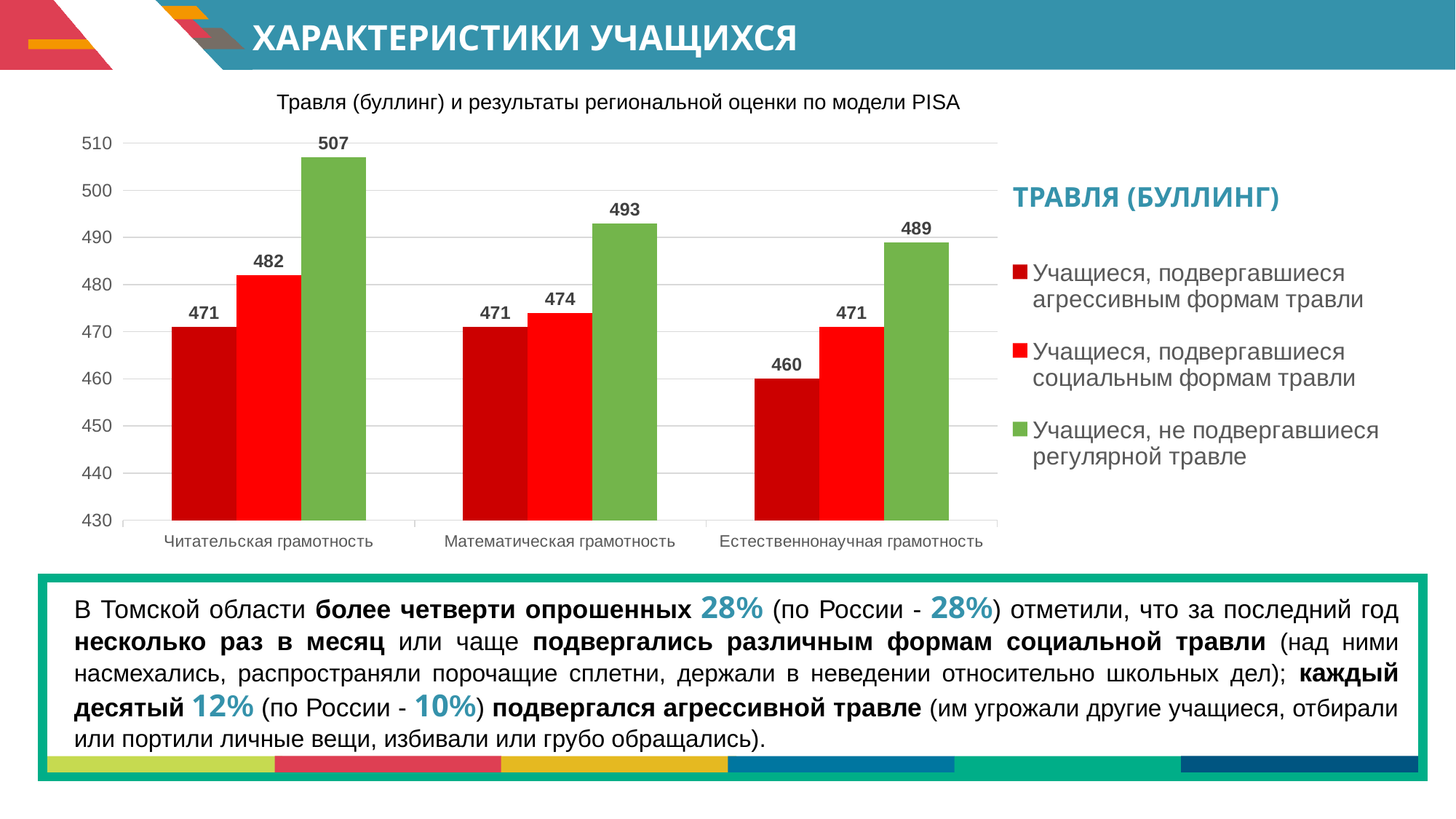
Какой результат по естественнонаучной грамотности у учащихся, подвергавшихся агрессивным формам травли? 460 Сколько видов грамотности (категорий) показано на диаграмме? 3 По какому виду грамотности учащиеся, не подвергавшиеся регулярной травле, показали самый высокий результат? Читательская грамотность Какого типа диаграмма представлена на слайде? Столбчатая (bar chart) На сколько баллов результат по читательской грамотности у учащихся, не подвергавшихся регулярной травле, выше, чем у учащихся, подвергавшихся агрессивным формам травли? 36 Кто показал более высокий результат по математической грамотности: учащиеся, подвергавшиеся социальным формам травли, или учащиеся, не подвергавшиеся регулярной травле? Учащиеся, не подвергавшиеся регулярной травле На сколько баллов результат по естественнонаучной грамотности у учащихся, подвергавшихся социальным формам травли, выше, чем у подвергавшихся агрессивным формам травли? 11 Каким цветом на диаграмме обозначены учащиеся, не подвергавшиеся регулярной травле? Зелёным По какому виду грамотности учащиеся, подвергавшиеся агрессивным формам травли, показали самый низкий результат? Естественнонаучная грамотность Какой результат по читательской грамотности у учащихся, не подвергавшихся регулярной травле? 507 Сколько групп учащихся (рядов) перечислено в легенде диаграммы? 3 Какой результат по математической грамотности у учащихся, подвергавшихся социальным формам травли? 474